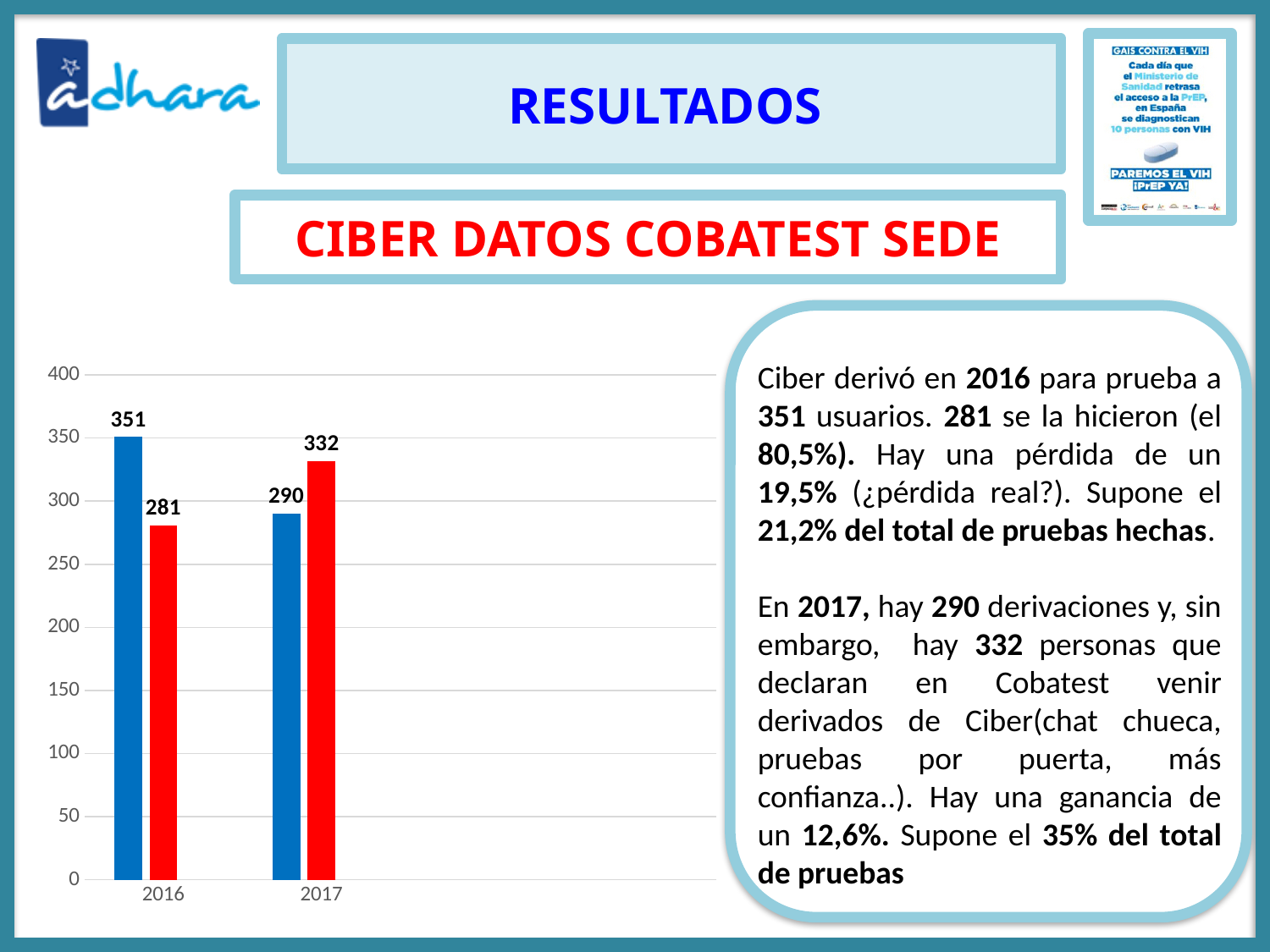
Does the value of the blue bar rise or fall from 2016 to 2017? Fall What is the difference between the red bar and the blue bar for 2017? 42 Which bar has the lowest value in the chart? The red bar for 2016 (281) What is the value of the red bar for 2017? 332 Which bar has the highest value in the chart? The blue bar for 2016 (351) For 2017, which is larger, the blue bar or the red bar? The red bar What is the value of the blue bar for 2016? 351 What is the value of the red bar for 2016? 281 What kind of chart is shown on the slide? Bar chart How many years are shown on the x axis of the chart? 2 What is the value of the blue bar for 2017? 290 What is the difference between the blue bar and the red bar for 2016? 70